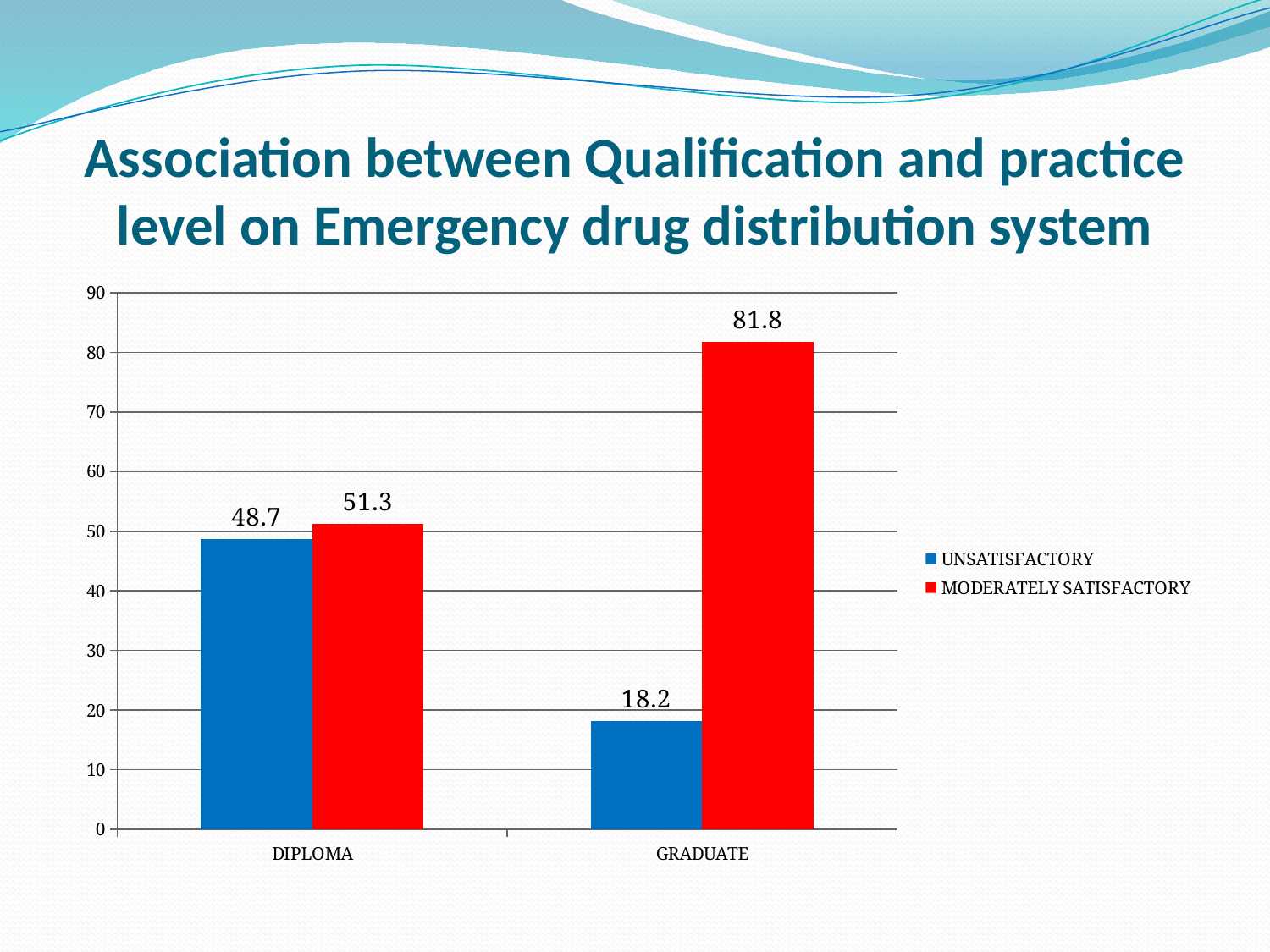
What is the difference between the UNSATISFACTORY values for DIPLOMA and GRADUATE? 30.5 Which is larger for DIPLOMA: the UNSATISFACTORY value or the MODERATELY SATISFACTORY value? MODERATELY SATISFACTORY How many categories are shown on the x axis? 2 What is the UNSATISFACTORY value for GRADUATE? 18.2 How many series does the legend list? 2 Which category has the highest MODERATELY SATISFACTORY value? GRADUATE Which category has the lowest UNSATISFACTORY value? GRADUATE What is the UNSATISFACTORY value for DIPLOMA? 48.7 What kind of chart is shown on the slide? Bar chart What is the MODERATELY SATISFACTORY value for GRADUATE? 81.8 What is the difference between the MODERATELY SATISFACTORY and UNSATISFACTORY values for GRADUATE? 63.6 What is the MODERATELY SATISFACTORY value for DIPLOMA? 51.3